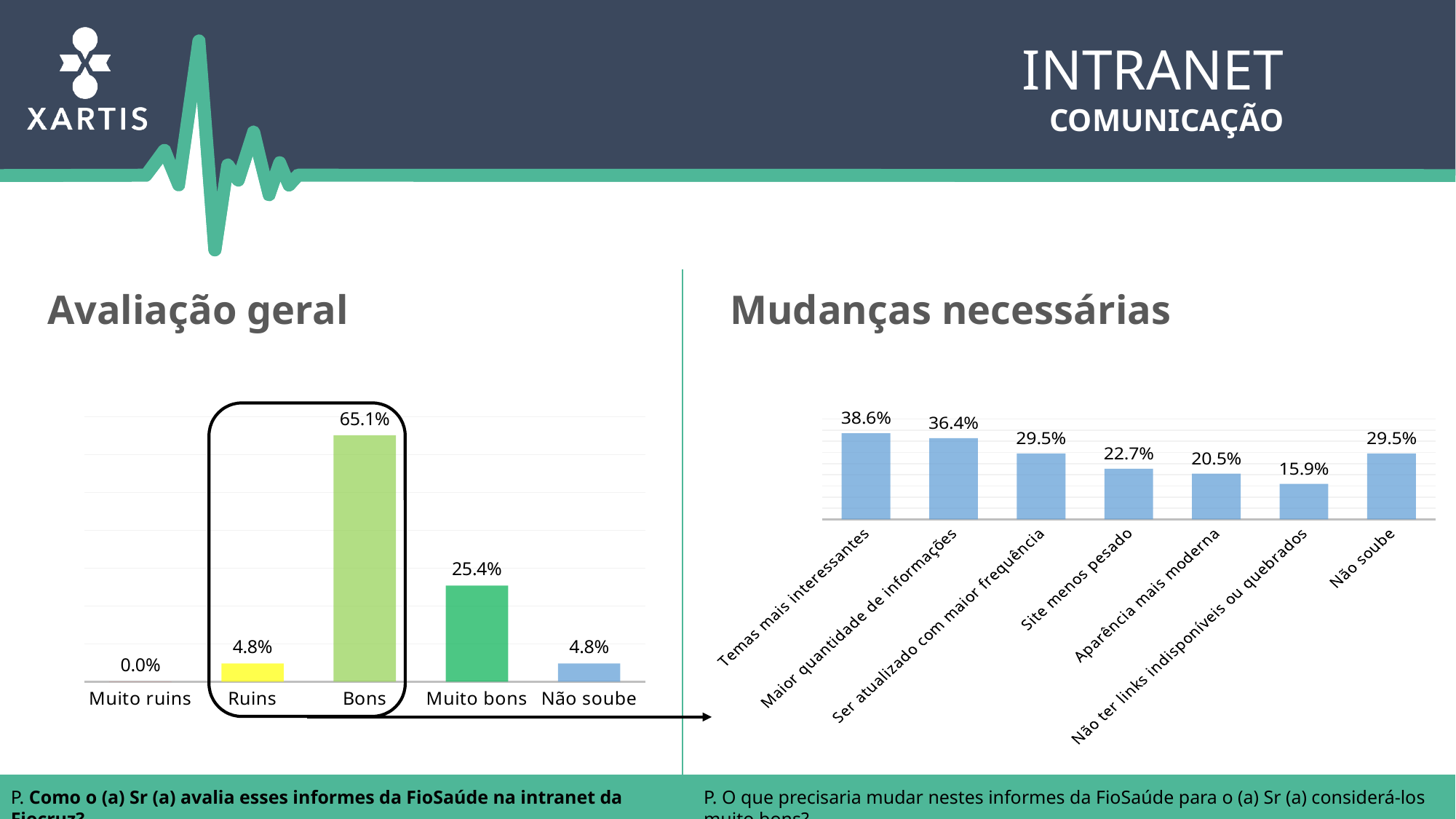
In the "Mudanças necessárias" chart, which is larger: Maior quantidade de informações or Aparência mais moderna? Maior quantidade de informações In the "Avaliação geral" chart, which category has the lowest value? Muito ruins How many categories are shown in the "Avaliação geral" chart? 5 In the "Avaliação geral" chart, which category has the highest value? Bons What type of chart is the "Mudanças necessárias" chart? Bar chart In the "Avaliação geral" chart, what is the difference between Bons and Muito bons? 39.7% How many categories are shown in the "Mudanças necessárias" chart? 7 In the "Mudanças necessárias" chart, what is the value for Temas mais interessantes? 38.6% In the "Mudanças necessárias" chart, which category has the lowest value? Não ter links indisponíveis ou quebrados In the "Avaliação geral" chart, what is the value for Bons? 65.1% In the "Mudanças necessárias" chart, what is the value for Site menos pesado? 22.7% In the "Avaliação geral" chart, what is the value for Muito bons? 25.4%